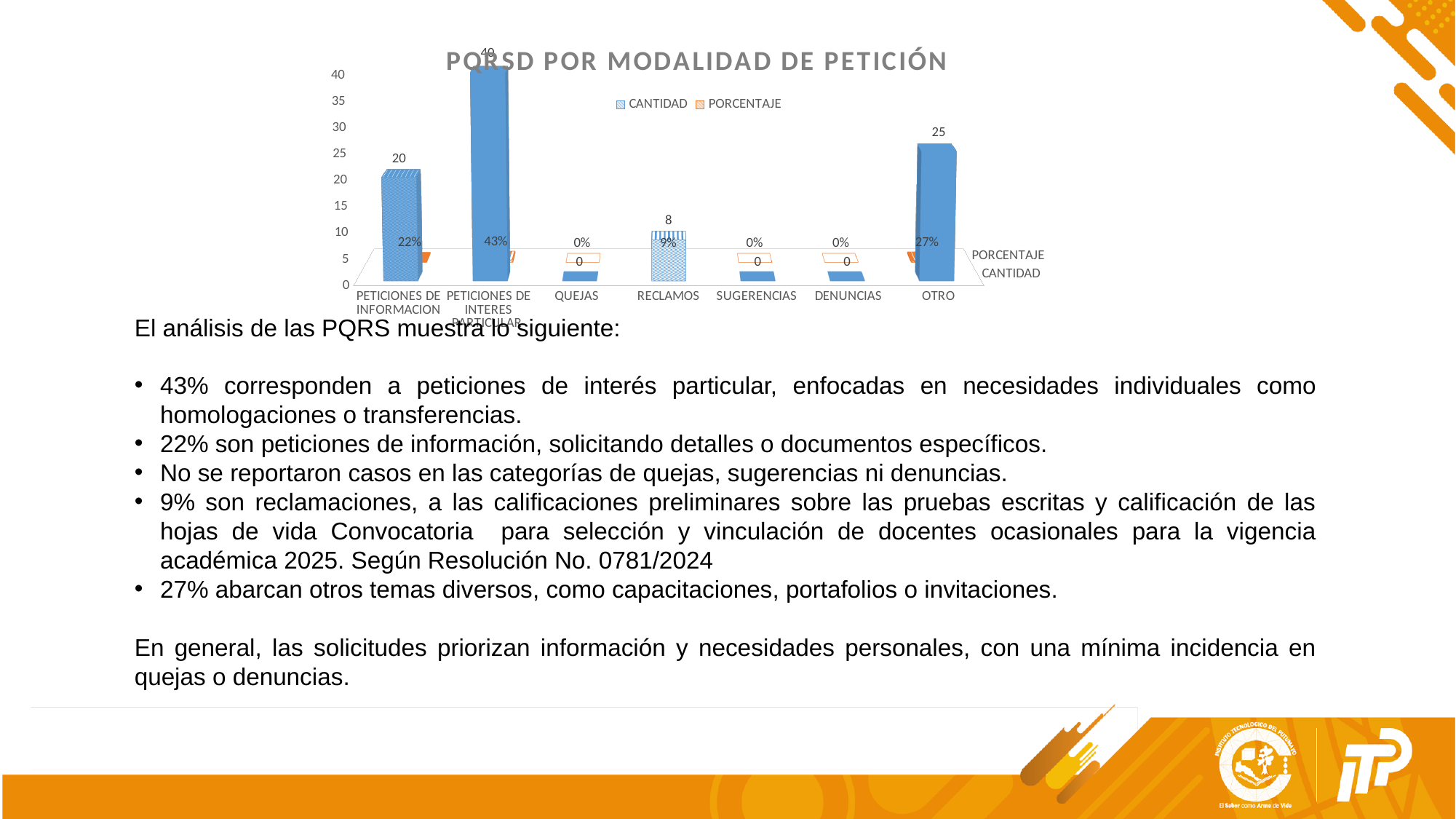
What kind of chart is shown on the slide? Bar chart What is the difference in CANTIDAD between OTRO and PETICIONES DE INFORMACION? 5 What is the CANTIDAD value for PETICIONES DE INFORMACION? 20 Which category has the highest CANTIDAD value? PETICIONES DE INTERES PARTICULAR What is the title of the chart? PQRSD POR MODALIDAD DE PETICIÓN What is the PORCENTAJE value for QUEJAS? 0% How many categories are shown on the x axis? 7 What is the CANTIDAD value for RECLAMOS? 8 Which has a larger CANTIDAD value, OTRO or RECLAMOS? OTRO What is the PORCENTAJE value for PETICIONES DE INTERES PARTICULAR? 43% What is the PORCENTAJE value for OTRO? 27% How many series does the legend list? 2